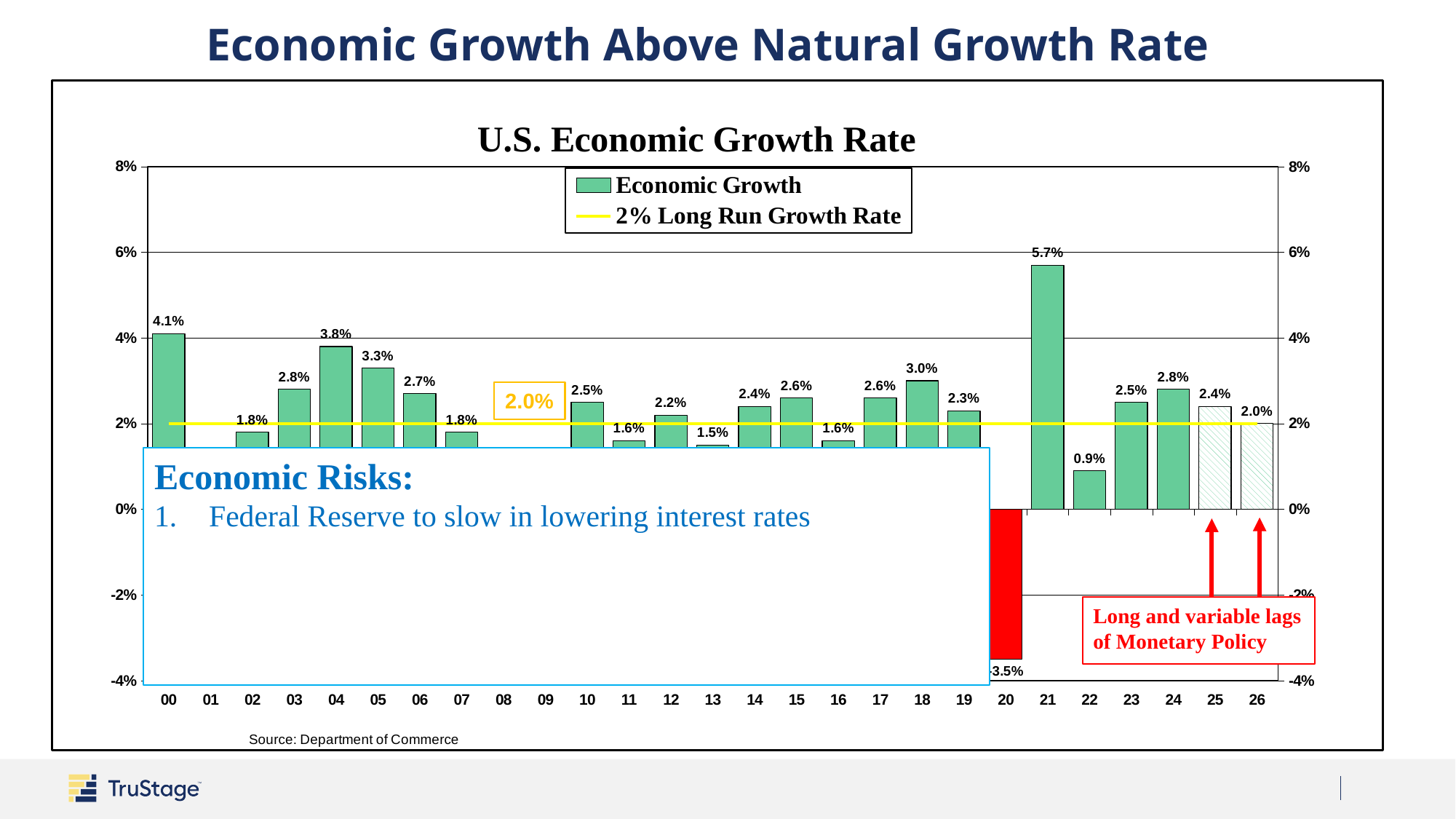
How many series does the legend list? 2 What is the difference between the Economic Growth values for 21 and 22? 4.8 percentage points What is the Economic Growth value for 22? 0.9% Which year has the highest Economic Growth value in the chart? 21 Which year has the lowest Economic Growth value in the chart? 20 What is the Economic Growth value for 00? 4.1% Is the Economic Growth value for 21 greater or less than 4%? greater What is the title of the chart? U.S. Economic Growth Rate What kind of chart is used to show Economic Growth? Bar chart What is the value of Economic Growth for 21 in the U.S. Economic Growth Rate chart? 5.7% Which year has a larger Economic Growth value, 04 or 05? 04 What is the Economic Growth value for 26? 2.0%